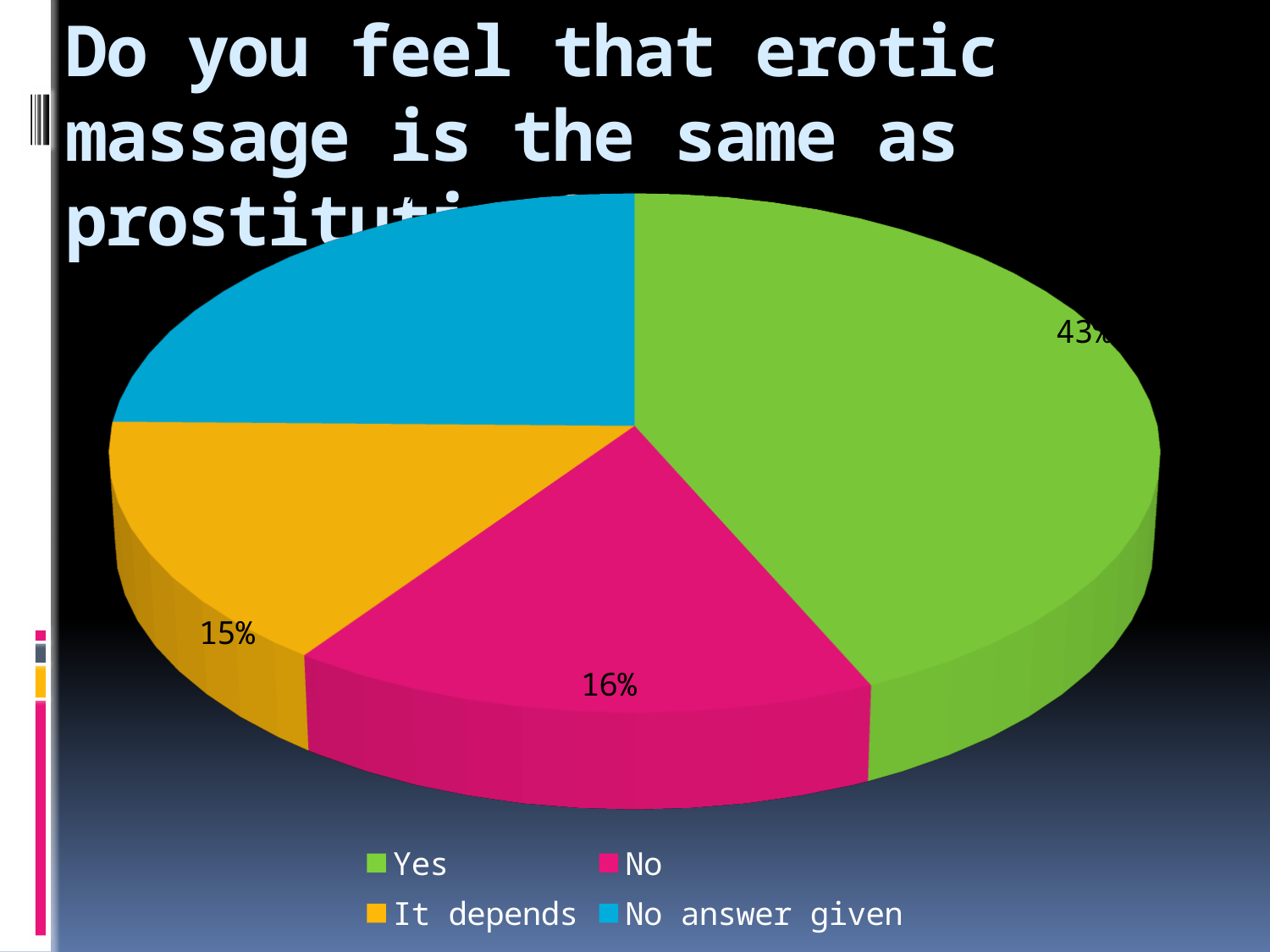
What kind of chart is shown on the slide? Pie chart How many slices does the pie chart have? 4 Which of the labelled slices has the smallest share? It depends Which response has the largest share of the pie? Yes What is the difference in percentage points between the Yes and No slices? 27 How many entries does the legend list? 4 What percentage of respondents answered It depends? 15% What percentage of respondents answered No? 16% Which slice is larger, Yes or No? Yes What share of the pie does the No slice represent? 16% What colour is the Yes slice? Green What percentage of respondents answered Yes? 43%